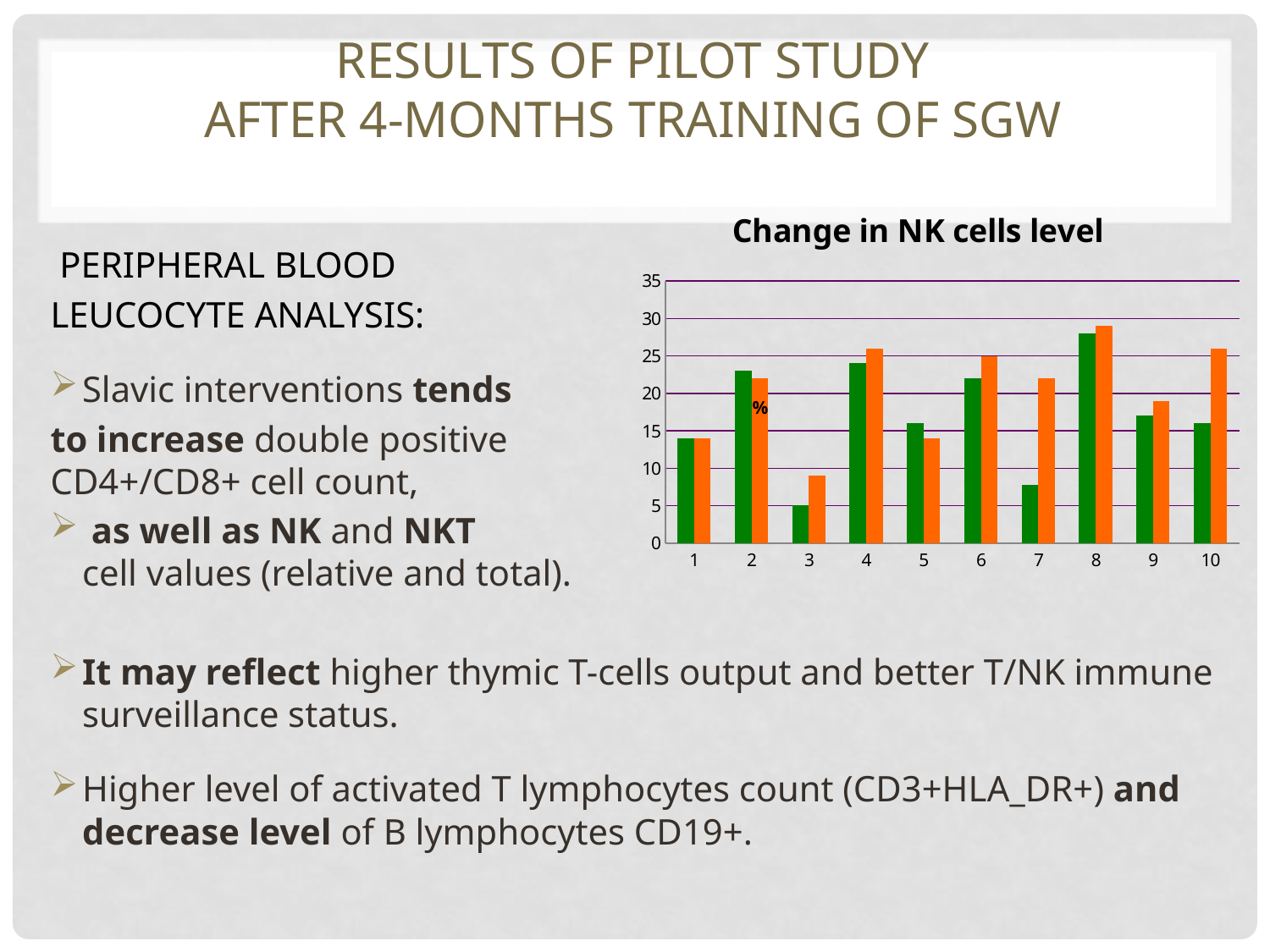
For category 7, which bar is taller, the green one or the orange one? orange Which category has the shortest green bar? 3 Which category has the tallest green bar? 8 What unit symbol is printed on the chart's value axis? % Is the orange bar for category 10 greater or less than 20? greater What is the title of the chart? Change in NK cells level Which category has the shortest orange bar? 3 What kind of chart is shown on the slide? bar chart How many bars are plotted for each category in the chart? 2 Which category has the tallest orange bar? 8 How many categories are shown along the x axis of the chart? 10 Is the green bar for category 7 greater or less than 10? less